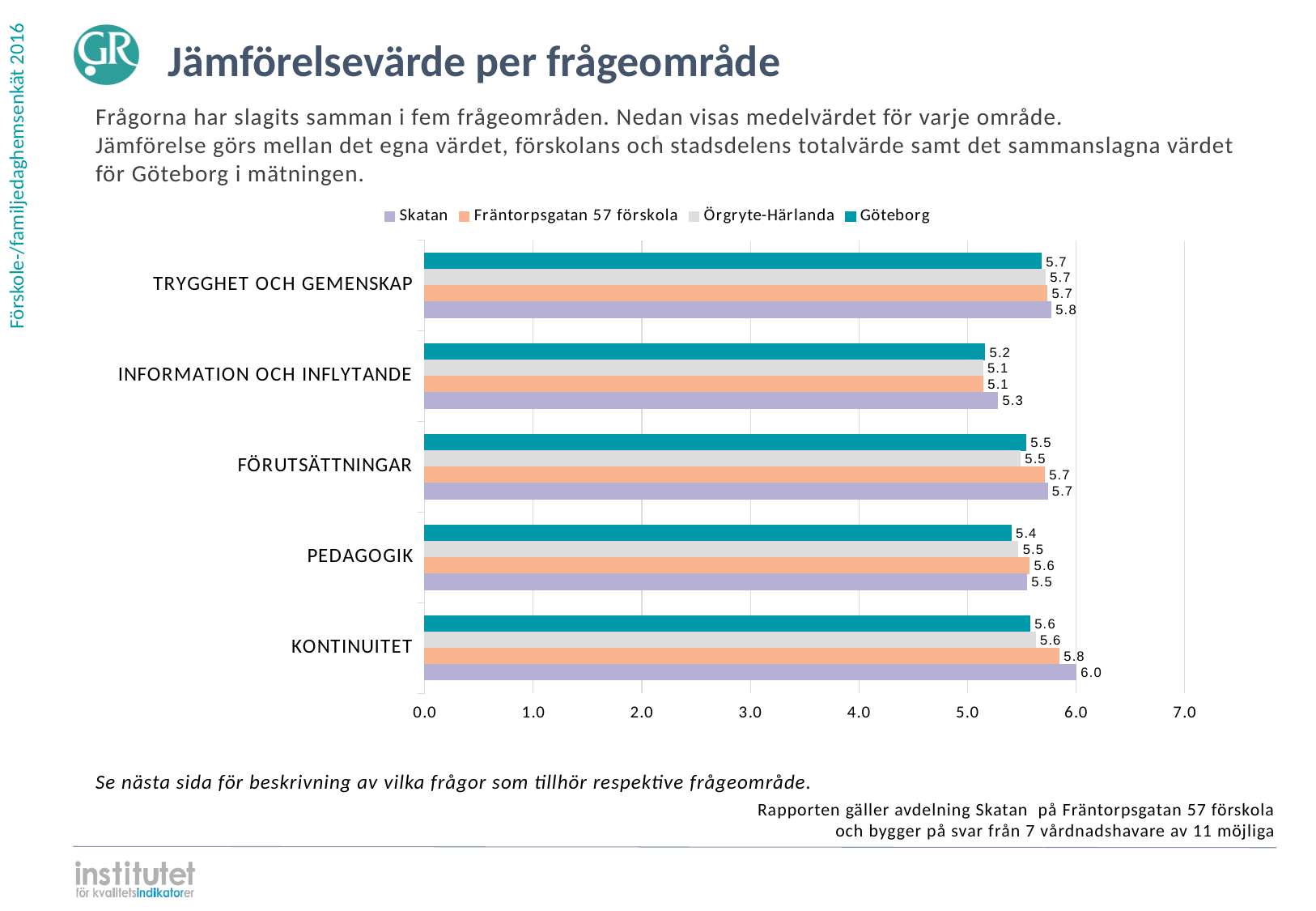
What is the difference between the Skatan value and the Göteborg value in KONTINUITET? 0.4 What is the value for Göteborg in INFORMATION OCH INFLYTANDE? 5.2 In INFORMATION OCH INFLYTANDE, which is larger: the value for Skatan or the value for Örgryte-Härlanda? Skatan How many series does the legend list? 4 Which series is shown in teal on the chart? Göteborg What is the value for Skatan in KONTINUITET? 6.0 In which question area does Skatan have its lowest value? INFORMATION OCH INFLYTANDE In which question area does Skatan have its highest value? KONTINUITET How many question areas (categories) are shown on the chart? 5 What is the value for Fräntorpsgatan 57 förskola in PEDAGOGIK? 5.6 What type of chart is shown on the slide? bar chart What is the value for Örgryte-Härlanda in FÖRUTSÄTTNINGAR? 5.5